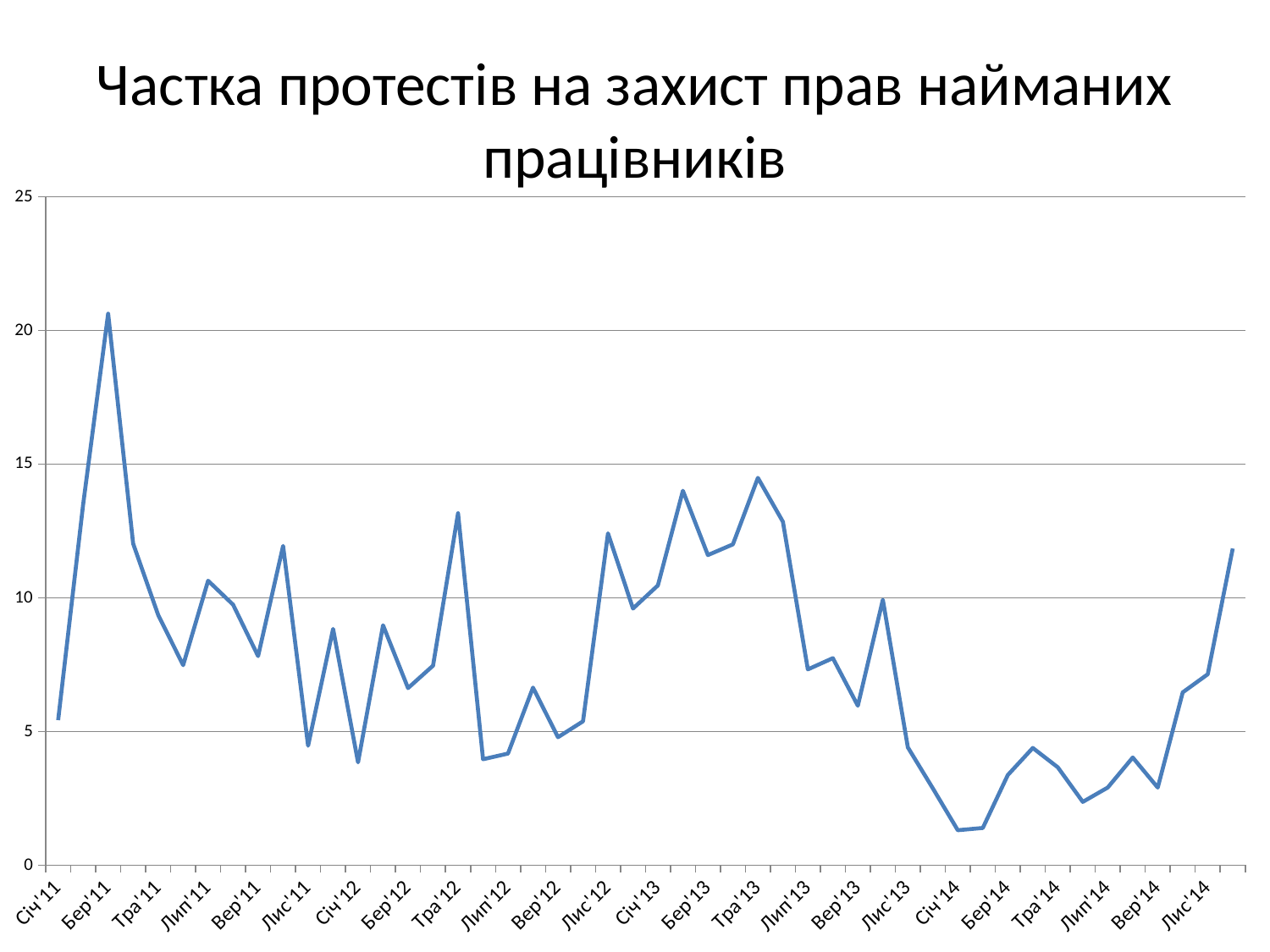
Which is larger, the value for Тра'12 or the value for Січ'14? Тра'12 What kind of chart is shown on the slide? line chart Is the value for Січ'12 greater or less than 5? less How many month labels are shown on the x axis? 24 Is the value for Січ'14 greater or less than 5? less Which month has the highest value on the chart? Бер'11 Is the value for Бер'11 greater or less than 20? greater What is the title of the chart? Частка протестів на захист прав найманих працівників Which is larger, the value for Бер'11 or the value for Тра'13? Бер'11